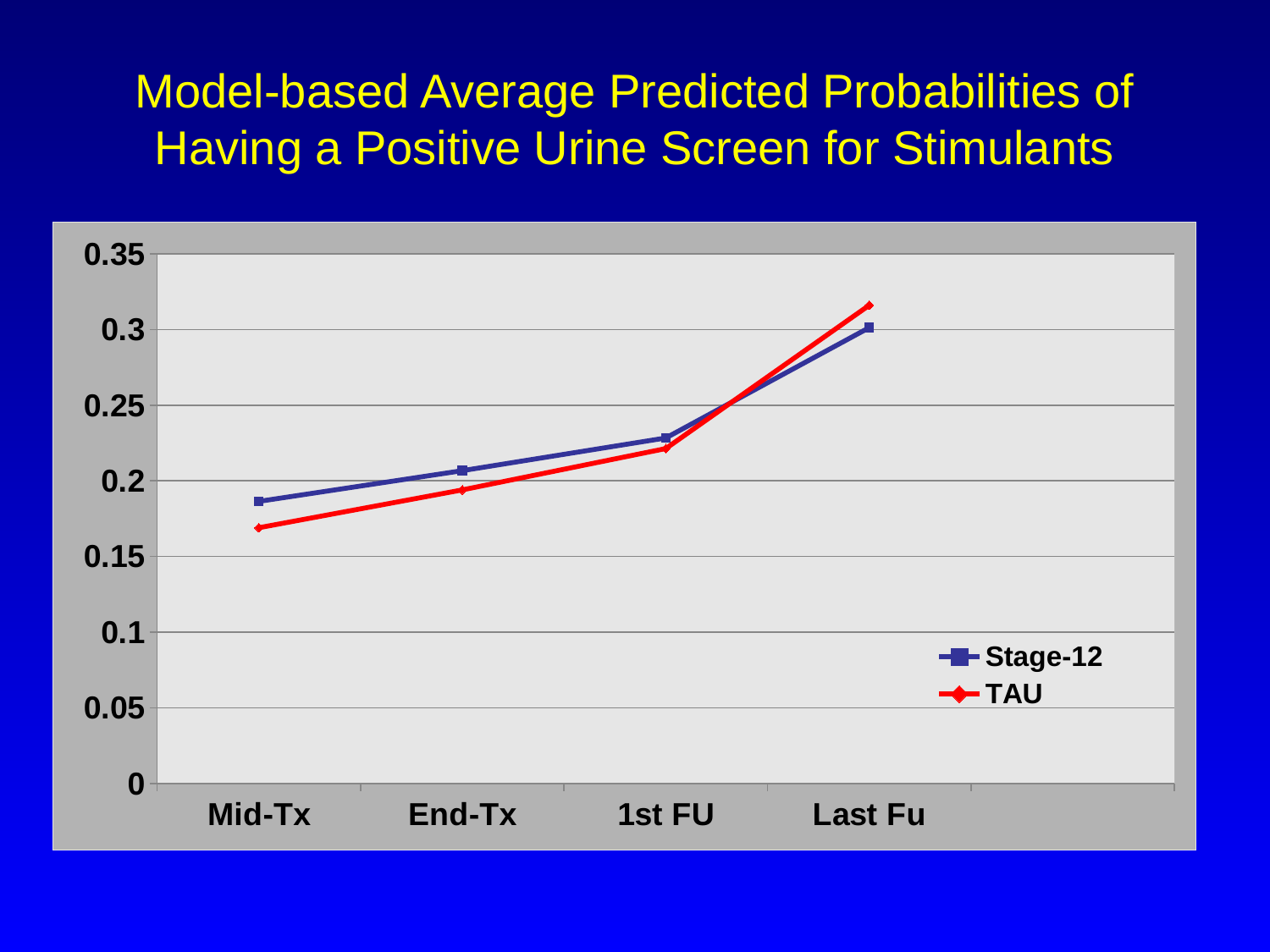
What kind of chart is shown on the slide? line chart At Last Fu, which series has the higher value, Stage-12 or TAU? TAU Is the value for TAU at Mid-Tx greater or less than 0.2? less Do the values for Stage-12 rise or fall from Mid-Tx to Last Fu? rise Is the value for TAU at Last Fu greater or less than 0.3? greater How many time points are shown on the x axis? 4 At which time point is the TAU value highest? Last Fu Is the value for Stage-12 at 1st FU greater or less than 0.25? less At Mid-Tx, which series has the higher value, Stage-12 or TAU? Stage-12 Which series is shown in red? TAU At which time point is the Stage-12 value lowest? Mid-Tx How many series does the legend list? 2